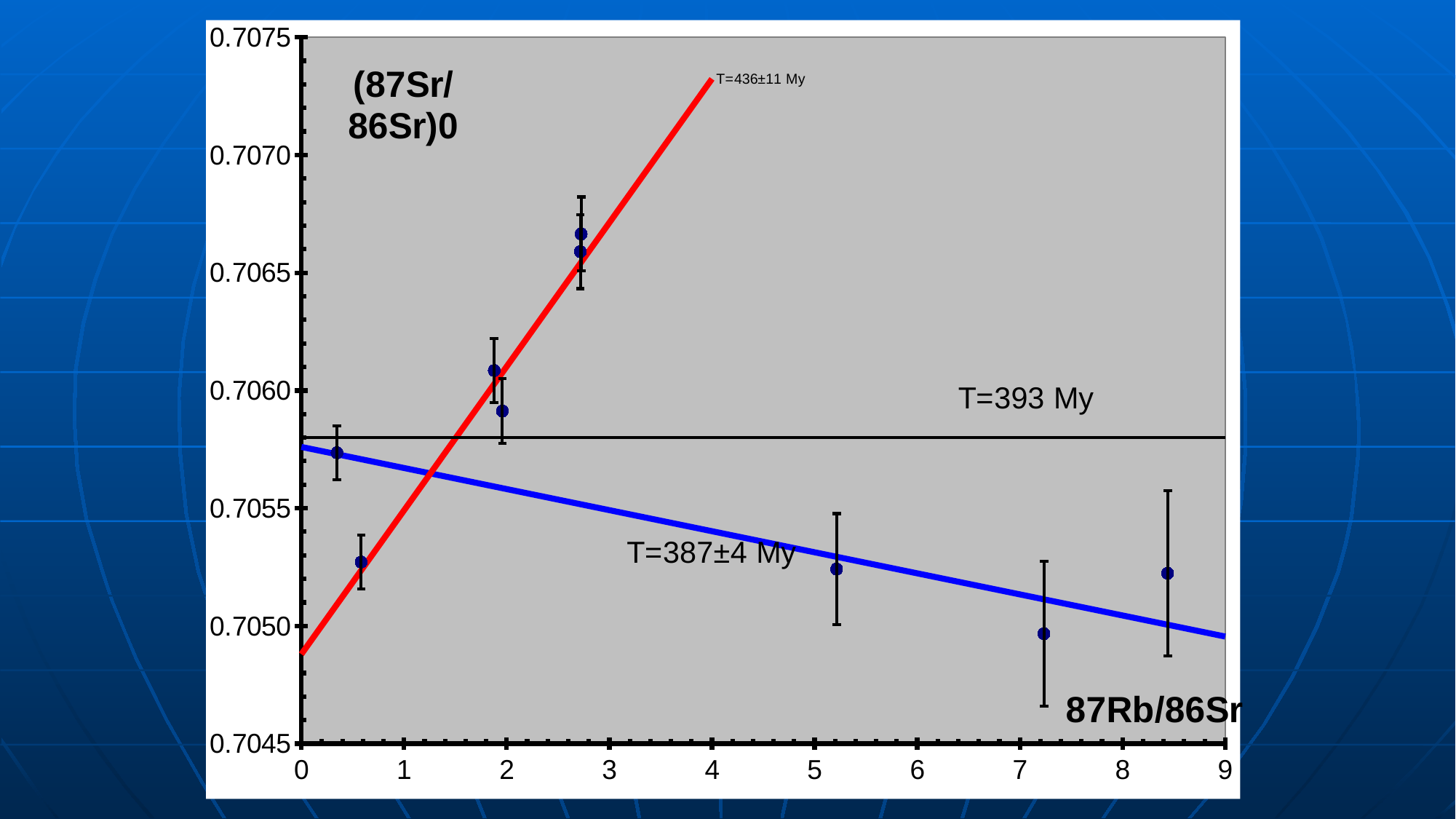
What is the label on the x axis of the chart? 87Rb/86Sr What age is written next to the red fitted line? T=436±11 My How many data points are plotted on the chart? 9 Is the (87Sr/86Sr)0 value of the data point near 87Rb/86Sr = 0.6 greater or less than 0.7055? less Does the blue fitted line rise or fall as 87Rb/86Sr increases? fall Is the (87Sr/86Sr)0 value of the data point near 87Rb/86Sr = 5.2 greater or less than 0.7050? greater Is the (87Sr/86Sr)0 value of the data point near 87Rb/86Sr = 0.35 greater or less than 0.7055? greater What is the highest tick value shown on the x axis? 9 Does the red fitted line rise or fall as 87Rb/86Sr increases? rise Which data point has the lower (87Sr/86Sr)0 value: the one near 87Rb/86Sr = 7.2 or the one near 87Rb/86Sr = 8.4? the one near 7.2 What kind of chart is shown on the slide? scatter chart